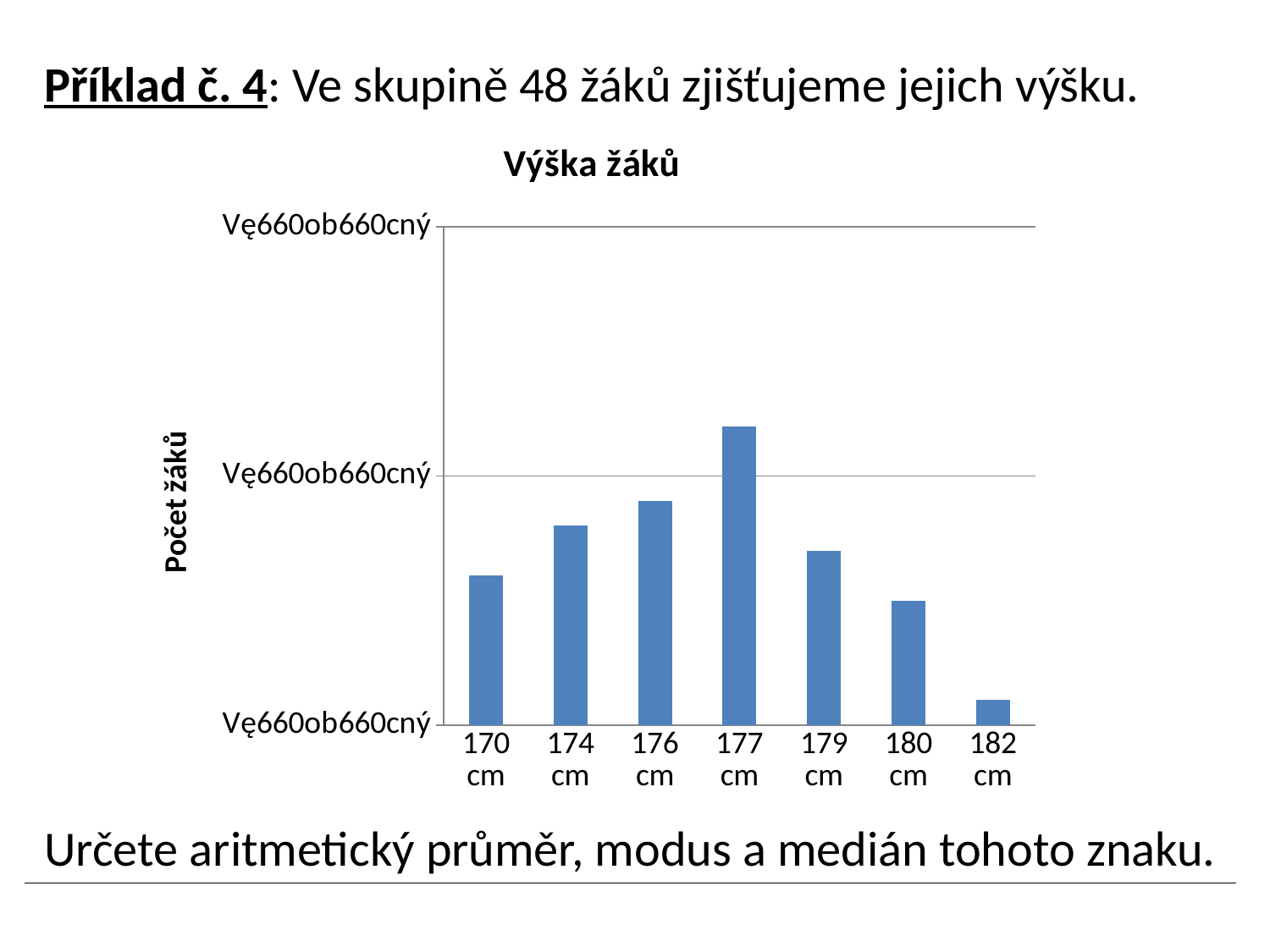
Which bar is taller, 174 cm or 179 cm? 174 cm How many height categories are shown on the x axis of the chart? 7 What kind of chart is shown on the slide? bar chart Do the bar heights rise or fall from 170 cm to 177 cm along the x axis? rise Which bar is taller, 176 cm or 179 cm? 176 cm What is the label of the vertical axis of the chart? Počet žáků Which bar is taller, 170 cm or 182 cm? 170 cm Do the bar heights rise or fall from 177 cm to 182 cm along the x axis? fall What is the title of the chart? Výška žáků Which height category has the highest bar in the chart? 177 cm Which height category has the lowest bar in the chart? 182 cm